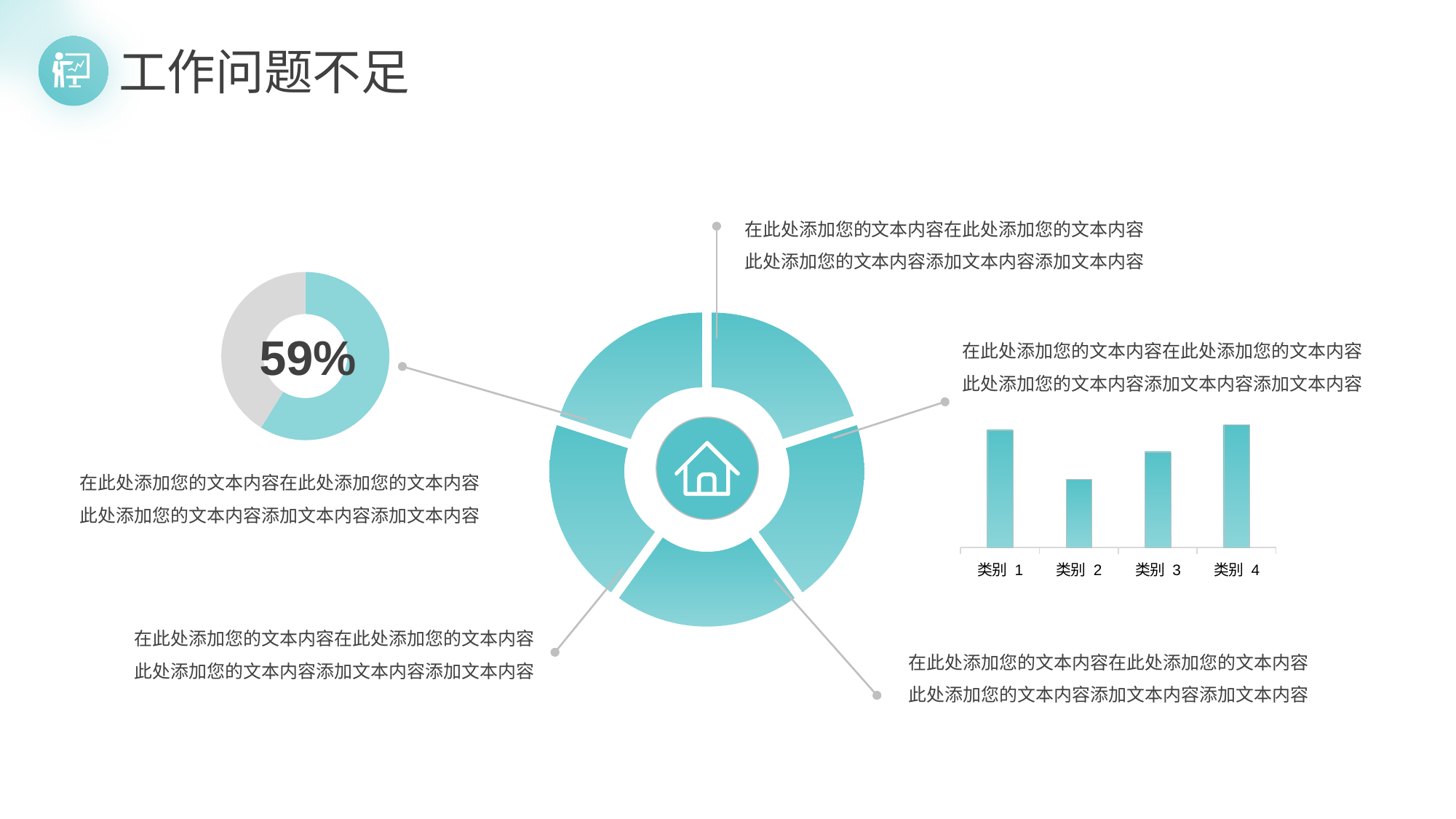
On the bar chart on the right, how many categories are shown? 4 On the bar chart on the right, which is taller, the bar for 类别 1 or the bar for 类别 3? 类别 1 On the donut chart on the left, what percentage is shown in the centre? 59% On the bar chart on the right, what is the label of the first category on the x axis? 类别 1 On the bar chart on the right, which category has the lowest bar? 类别 2 On the donut chart on the left, what share of the ring does the teal segment represent? 59% On the bar chart on the right, which category has the highest bar? 类别 4 On the donut chart on the left, is the teal segment larger or smaller than half of the ring? Larger On the bar chart on the right, what colour are the bars? Teal What kind of chart is the chart on the left of the slide showing 59%? Donut chart On the bar chart on the right, which is taller, the bar for 类别 2 or the bar for 类别 4? 类别 4 What kind of chart is the chart on the right of the slide with 类别 1 to 类别 4? Bar chart